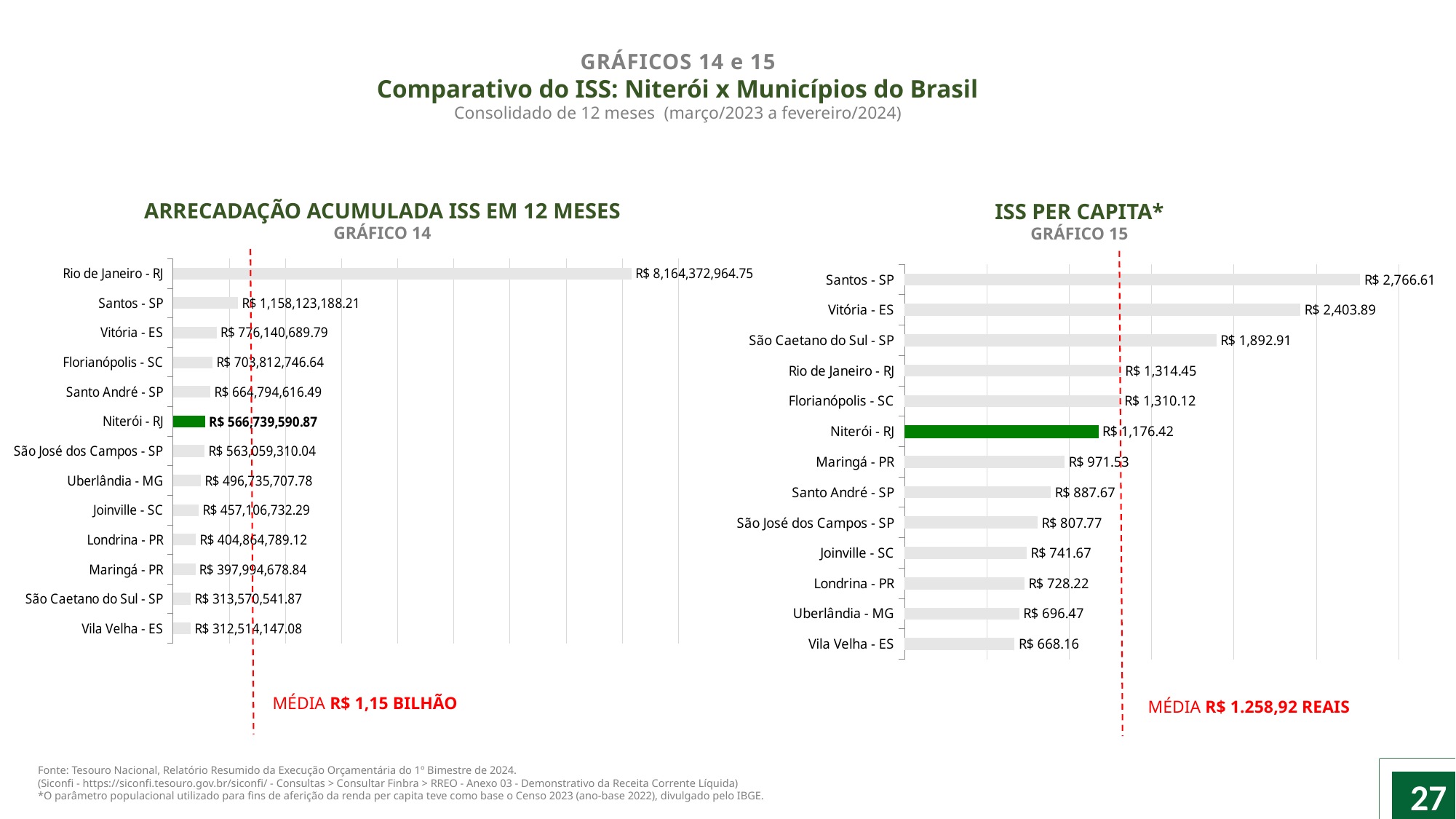
In Gráfico 15 (ISS per capita), what is the difference between Santos - SP and Vitória - ES? R$ 362.72 In Gráfico 15 (ISS per capita), what average (média) is indicated by the red dashed line? R$ 1.258,92 reais In Gráfico 14 (Arrecadação acumulada ISS em 12 meses), how many municipalities are shown? 13 In Gráfico 15 (ISS per capita), what is the value for Santos - SP? R$ 2,766.61 In Gráfico 15 (ISS per capita), which municipality has the highest value? Santos - SP In Gráfico 14 (Arrecadação acumulada ISS em 12 meses), which municipality has the lowest value? Vila Velha - ES In Gráfico 14 (Arrecadação acumulada ISS em 12 meses), what is the value for Niterói - RJ? R$ 566,739,590.87 What type of chart is Gráfico 14? Bar chart In Gráfico 15 (ISS per capita), what is the value for Niterói - RJ? R$ 1,176.42 In Gráfico 14 (Arrecadação acumulada ISS em 12 meses), what is the value for Rio de Janeiro - RJ? R$ 8,164,372,964.75 In Gráfico 15 (ISS per capita), which is larger: the value for Maringá - PR or the value for Santo André - SP? Maringá - PR In Gráfico 15 (ISS per capita), which municipality has the lowest value? Vila Velha - ES